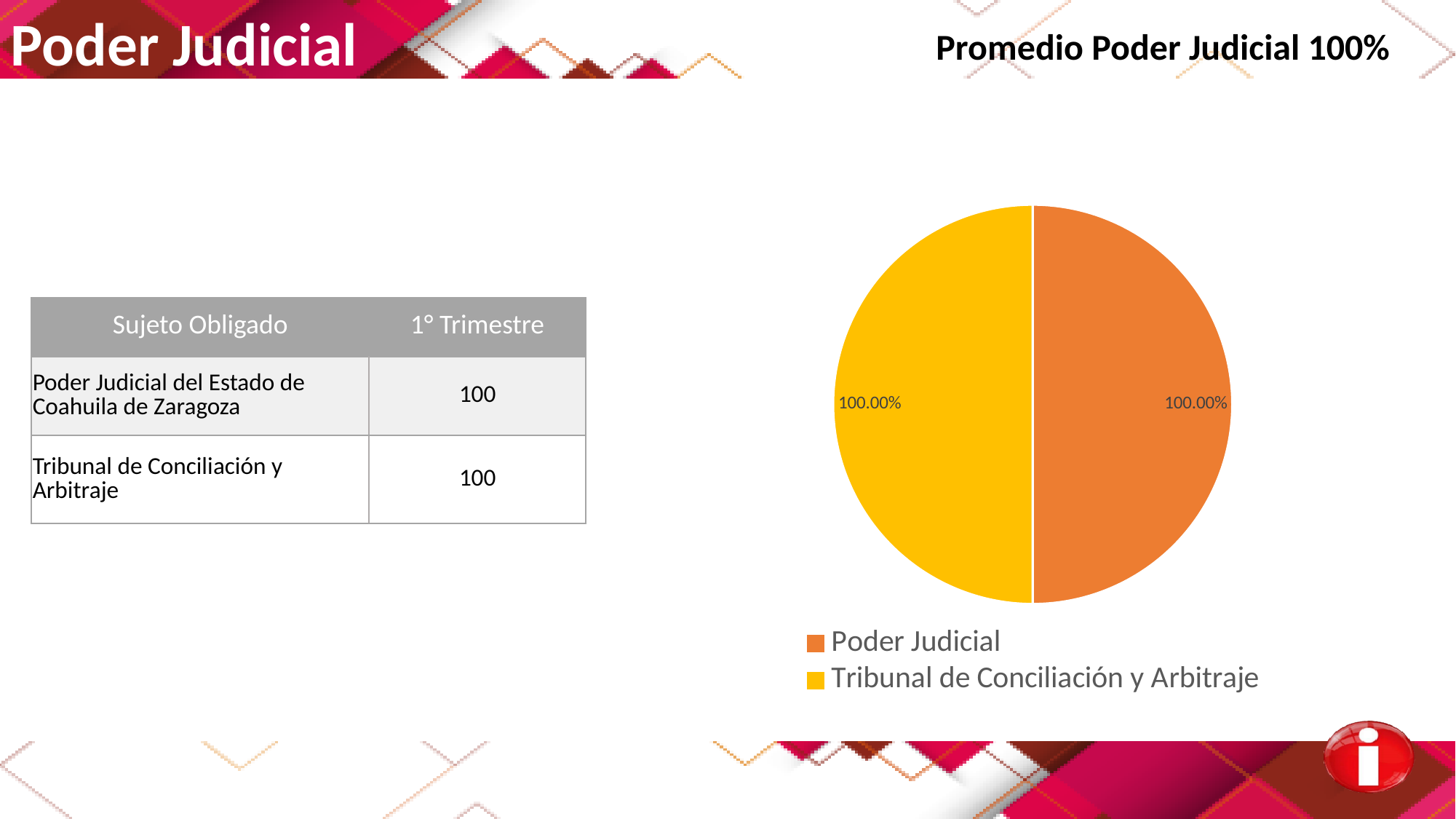
How many slices does the pie chart have? 2 What data label is shown on the Poder Judicial slice of the pie chart? 100.00% What data label is shown on the Tribunal de Conciliación y Arbitraje slice of the pie chart? 100.00% Is the data label on the Poder Judicial slice greater or less than 50%? greater How many entries does the legend of the pie chart list? 2 What kind of chart is shown on the slide? pie chart Do the two slices of the pie chart show the same data label value? yes Which colour represents Poder Judicial in the pie chart? orange Which colour represents Tribunal de Conciliación y Arbitraje in the pie chart? yellow